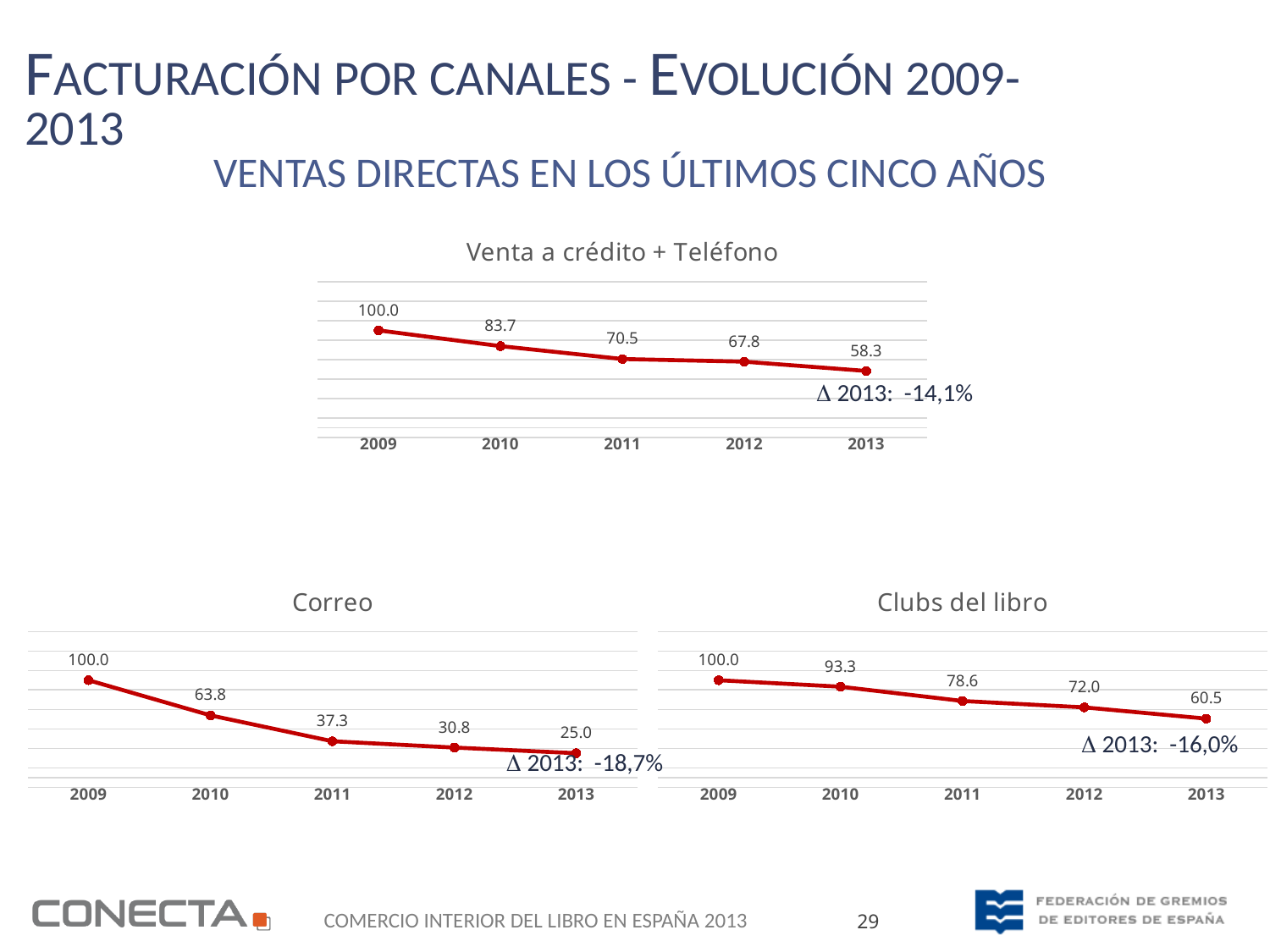
In the 'Venta a crédito + Teléfono' chart, what is the difference between the 2009 and 2013 values? 41.7 What type of chart is the 'Correo' chart? Line chart In the 'Correo' chart, what is the value for 2010? 63.8 In the 'Venta a crédito + Teléfono' chart, what is the value for 2011? 70.5 In the 'Correo' chart, which year has the lowest value? 2013 In the 'Clubs del libro' chart, what is the value for 2013? 60.5 In the 'Clubs del libro' chart, which year has the highest value? 2009 In the 'Clubs del libro' chart, how many data points are plotted? 5 In the 'Venta a crédito + Teléfono' chart, do the values rise or fall from 2009 to 2013? Fall What change for 2013 is annotated on the 'Clubs del libro' chart? Δ 2013: -16,0% In the 'Correo' chart, what is the difference between the 2011 and 2012 values? 6.5 Which is larger: the 2012 value in the 'Correo' chart or the 2012 value in the 'Clubs del libro' chart? Clubs del libro